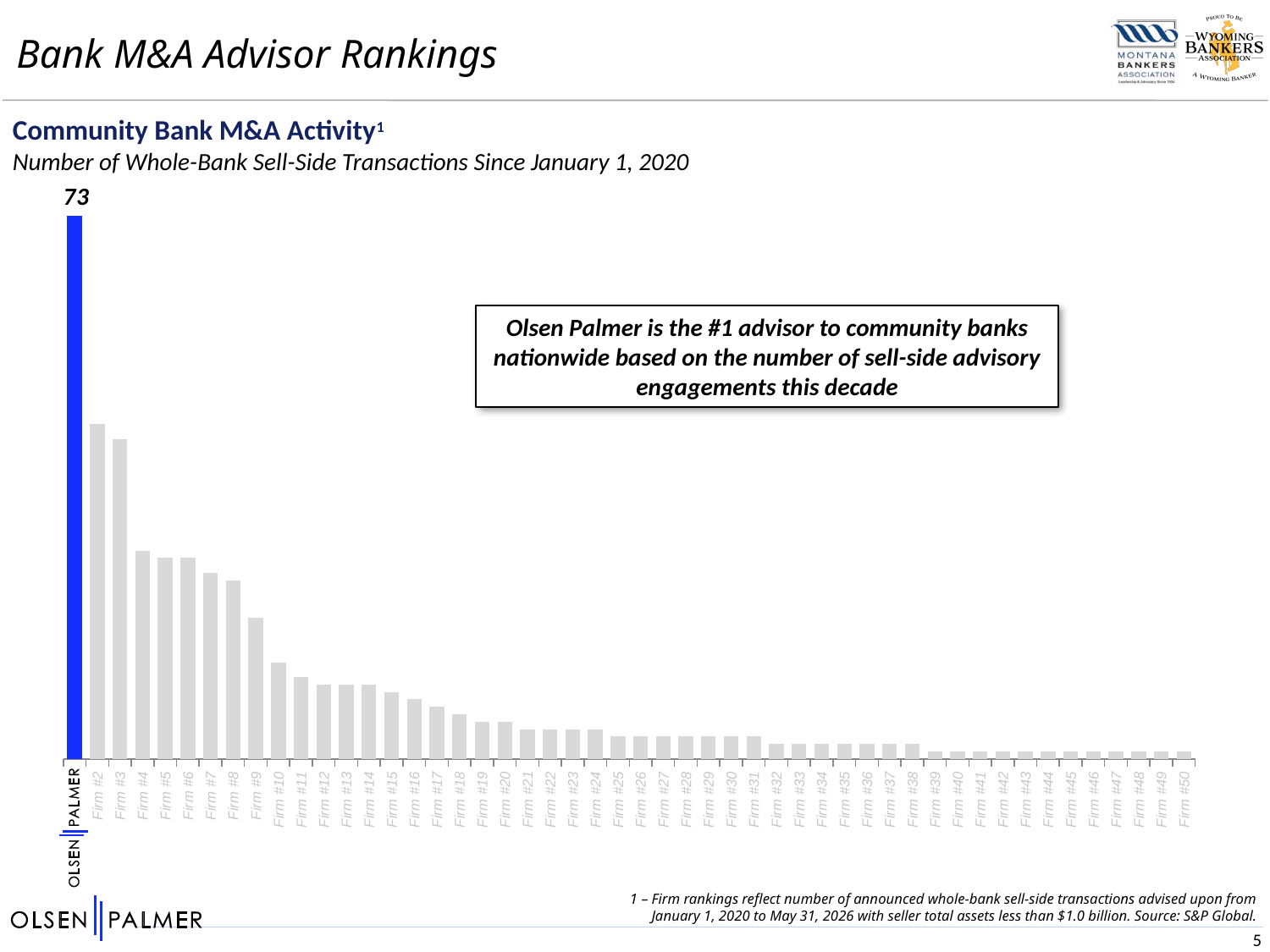
What is the title of the chart? Community Bank M&A Activity Which has more transactions, Firm #2 or Firm #10? Firm #2 What kind of chart is shown on the slide? Bar chart How many firms are shown along the x axis of the chart? 50 Which has more transactions, Firm #4 or Firm #20? Firm #4 Which firm has the highest number of transactions in the chart? Olsen Palmer What is the number of whole-bank sell-side transactions shown for Olsen Palmer? 73 Which has more transactions, Olsen Palmer or Firm #2? Olsen Palmer Do the bar values rise or fall moving from left to right along the x axis? Fall What colour is the bar for Olsen Palmer? Blue